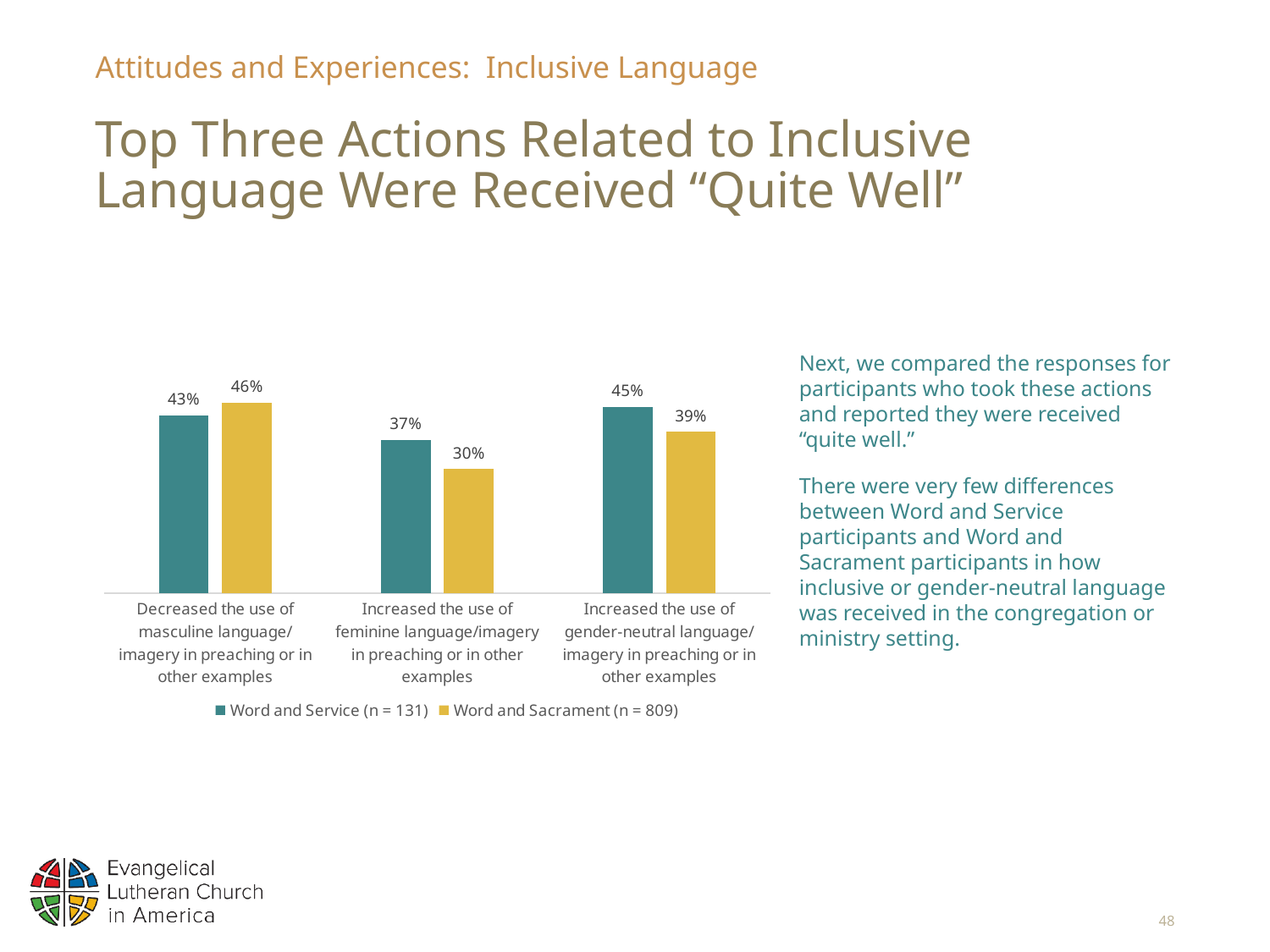
Which action has the highest value for Word and Sacrament participants? Decreased the use of masculine language/imagery in preaching or in other examples How many action categories are shown on the x axis of the chart? 3 For increasing the use of gender-neutral language/imagery, which group has the larger value: Word and Service or Word and Sacrament? Word and Service What is the Word and Sacrament value for increasing the use of feminine language/imagery in preaching or in other examples? 30% How many series does the chart legend list? 2 What is the sample size (n) for the Word and Sacrament series shown in the legend? 809 Which action has the lowest value for Word and Service participants? Increased the use of feminine language/imagery in preaching or in other examples Which colour represents the Word and Service series in the chart? Teal What is the difference between the Word and Service and Word and Sacrament values for increasing the use of feminine language/imagery? 7 percentage points What is the Word and Service value for increasing the use of gender-neutral language/imagery? 45% What kind of chart is shown on the slide? Bar chart What percentage of Word and Service participants reported that decreasing the use of masculine language/imagery was received quite well? 43%